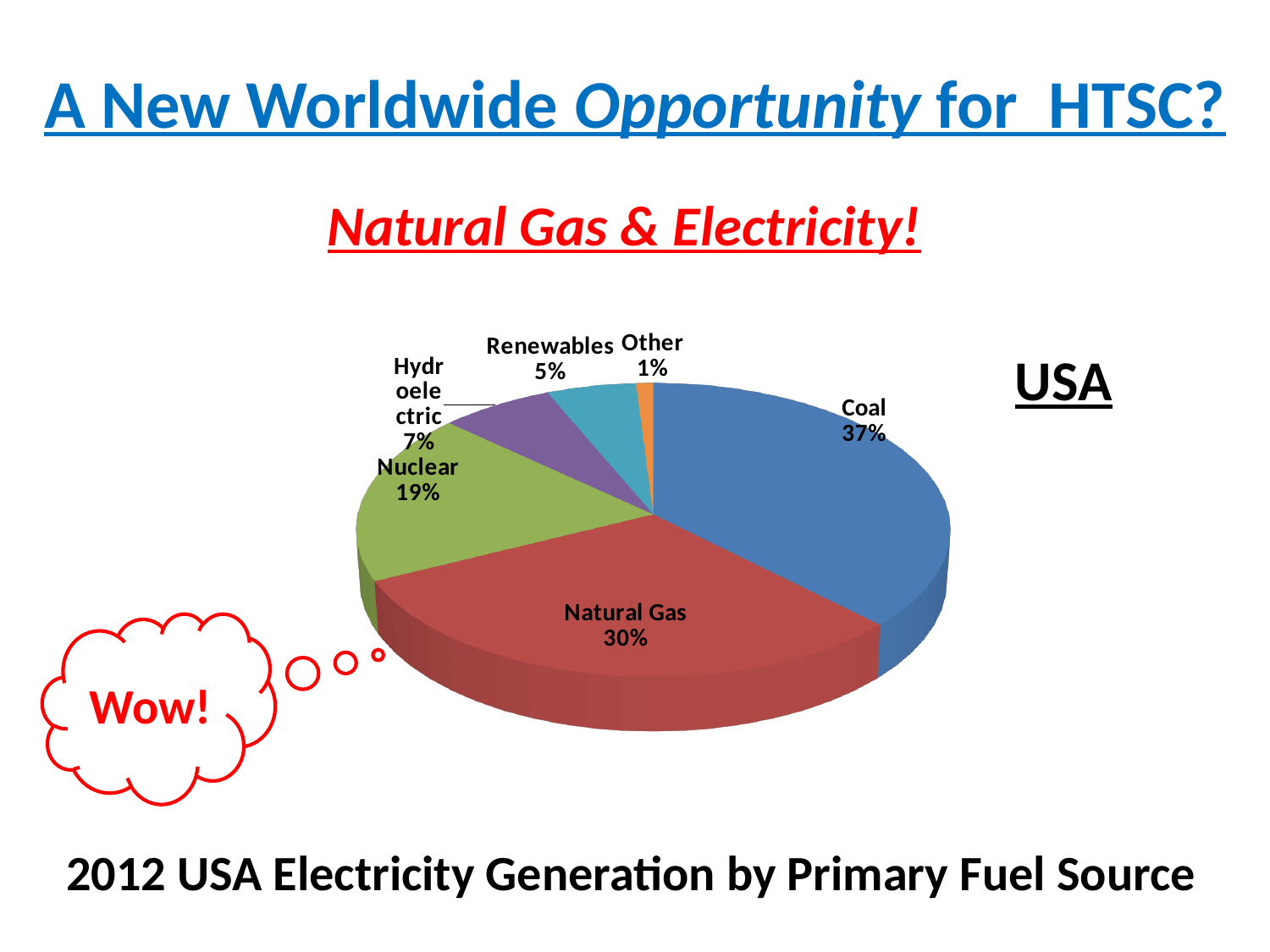
What share of the pie is labelled Natural Gas? 30% Which fuel source has the smallest slice of the pie? Other What share of 2012 USA electricity generation came from Coal? 37% What percentage is shown for Nuclear? 19% What percentage is shown for Renewables? 5% What kind of chart is shown on the slide? Pie chart What is the difference in percentage points between Coal and Natural Gas? 7 Which is larger, the Nuclear slice or the Hydroelectric slice? Nuclear Which fuel source has the largest slice of the pie? Coal What is the caption below the chart? 2012 USA Electricity Generation by Primary Fuel Source How many fuel source categories are shown in the pie chart? 6 What percentage is shown for Hydroelectric? 7%